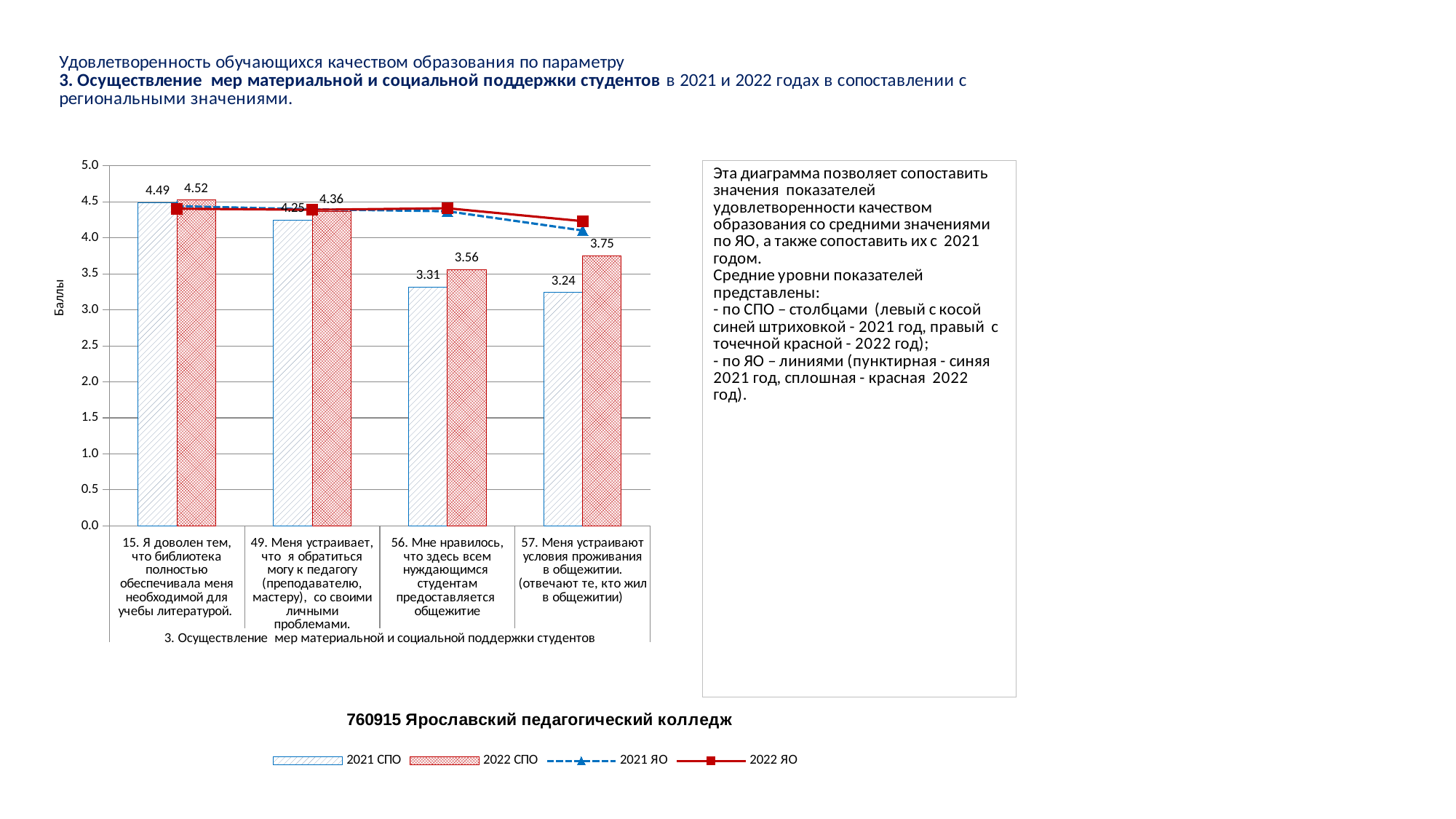
How many series does the legend list? 4 What is the value of the 2021 СПО bar for category 15 (Я доволен тем, что библиотека полностью обеспечивала меня необходимой для учебы литературой)? 4.49 Is the 2022 ЯО line value for category 57 greater or less than 4.0? greater What is the value of the 2021 СПО bar for category 56 (Мне нравилось, что здесь всем нуждающимся студентам предоставляется общежитие)? 3.31 Which category has the highest 2022 СПО bar? 15. Я доволен тем, что библиотека полностью обеспечивала меня необходимой для учебы литературой What is the difference between the 2022 СПО and 2021 СПО bars for category 56? 0.25 Which category has the lowest 2021 СПО bar? 57. Меня устраивают условия проживания в общежитии How many categories are shown on the x axis? 4 What is the difference between the 2022 СПО and 2021 СПО bars for category 57? 0.51 What is the value of the 2022 СПО bar for category 57 (Меня устраивают условия проживания в общежитии)? 3.75 For category 49, which is larger: the 2021 СПО bar or the 2022 СПО bar? 2022 СПО What is the value of the 2022 СПО bar for category 49 (Меня устраивает, что я могу обратиться к педагогу)? 4.36